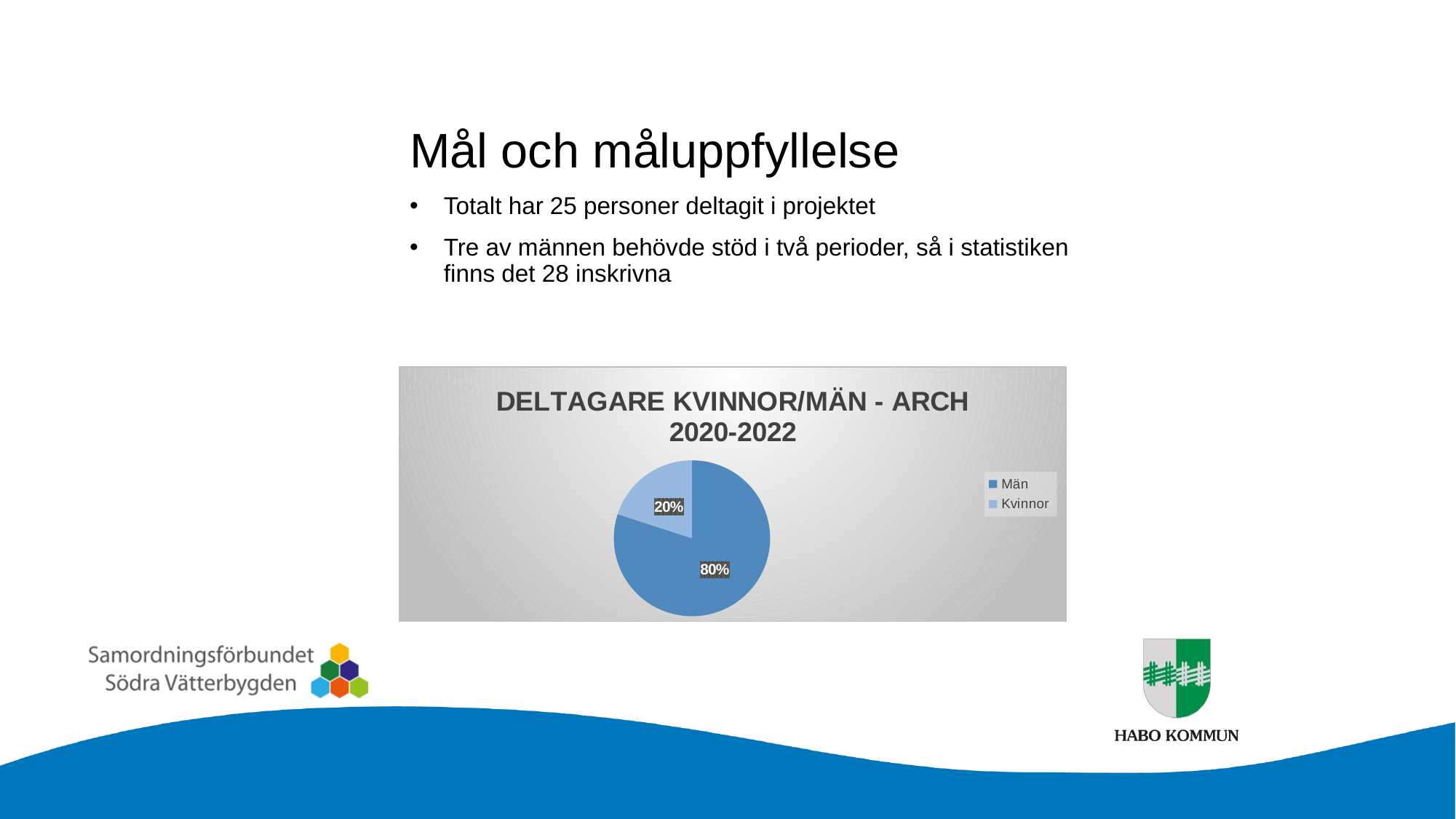
What is the total of the two slice percentages shown on the pie? 100% What is the title of the chart? DELTAGARE KVINNOR/MÄN - ARCH 2020-2022 What share of the pie does Kvinnor represent? 20% Which slice is larger, Män or Kvinnor? Män What share of the pie does Män represent? 80% Which category has the smallest slice of the pie? Kvinnor What is the difference in percentage points between the Män and Kvinnor slices? 60 How many categories does the pie chart show? 2 What kind of chart is shown on the slide? Pie chart Which entries does the chart legend list? Män, Kvinnor Which category has the largest slice of the pie? Män